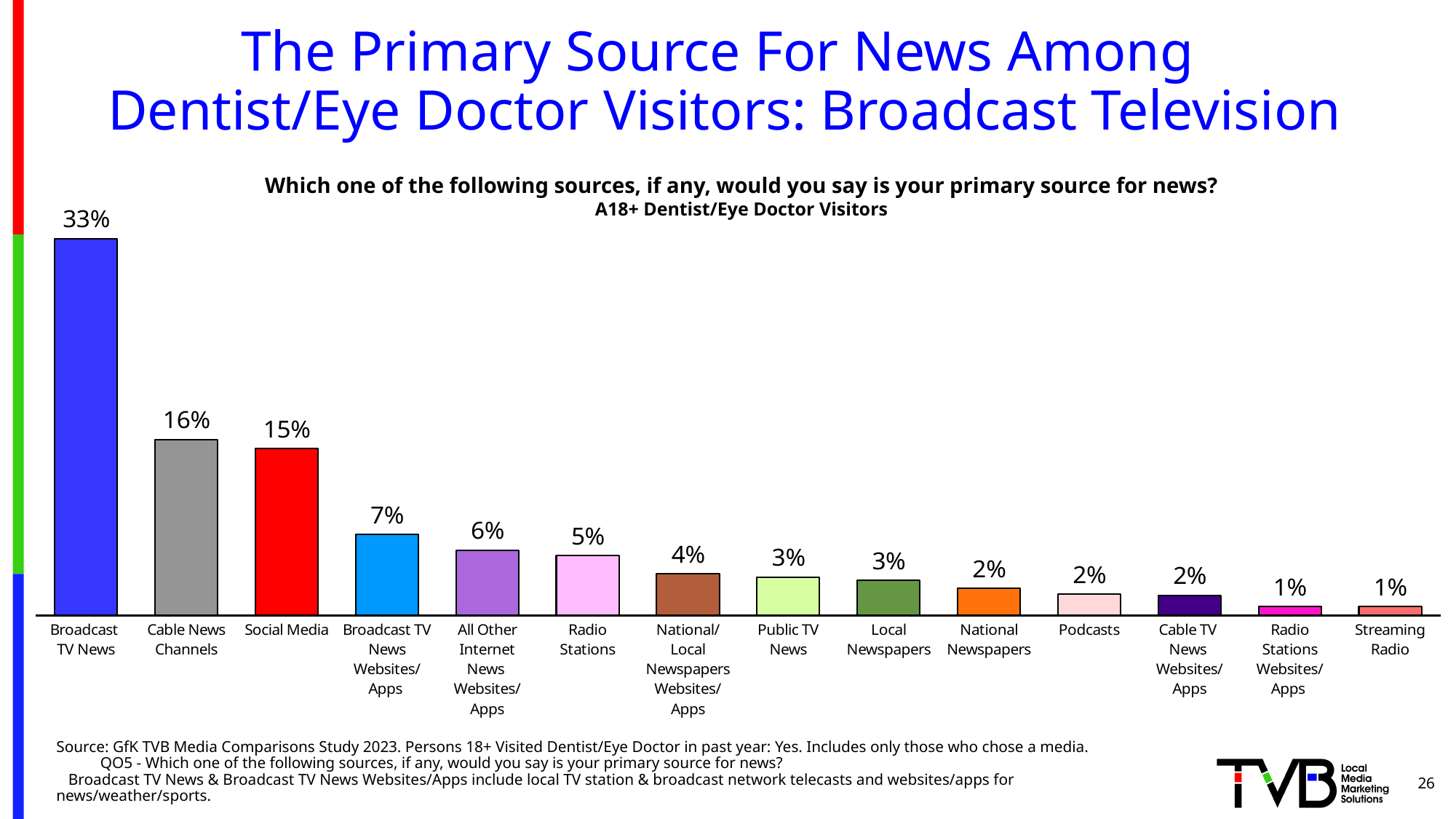
What is the value shown for Radio Stations? 5% What percentage of A18+ Dentist/Eye Doctor Visitors say Broadcast TV News is their primary source for news? 33% How many sources (bars) are shown in the chart? 14 Do the values rise or fall moving from left to right along the x axis? Fall Which is larger, the value for Social Media or the value for Radio Stations? Social Media What kind of chart is shown on the slide? Bar chart What is the difference between the values for Broadcast TV News and Cable News Channels? 17% What is the value shown for Social Media? 15% What is the difference between the values for Broadcast TV News Websites/Apps and All Other Internet News Websites/Apps? 1% What is the value shown for Cable News Channels? 16% Which is larger, the value for National/Local Newspapers Websites/Apps or the value for Podcasts? National/Local Newspapers Websites/Apps Which source has the highest value in the chart? Broadcast TV News